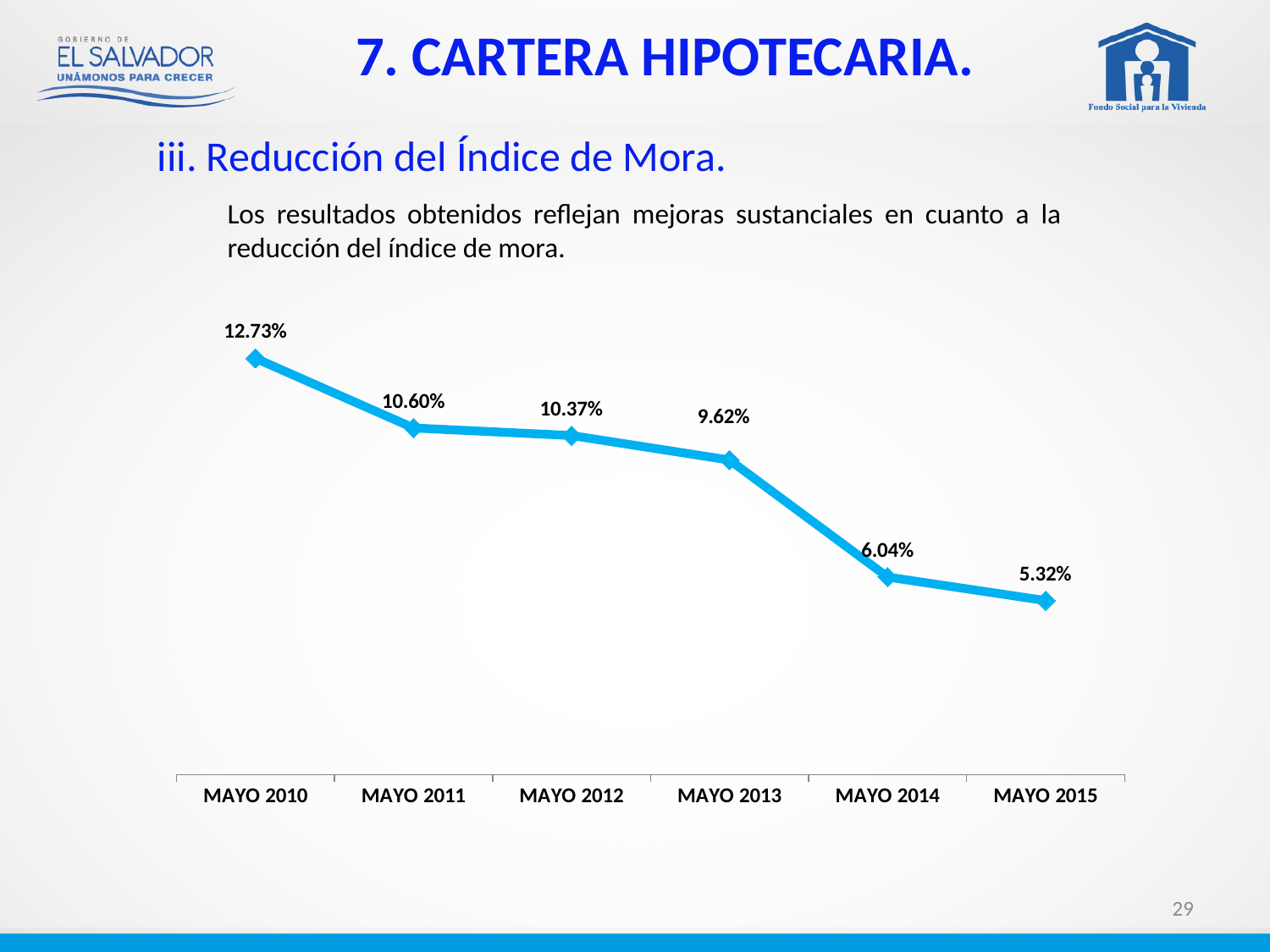
What is the value for MAYO 2015? 5.32% What is the difference between the values for MAYO 2013 and MAYO 2014? 3.58% Which category has the highest value? MAYO 2010 Which category has the lowest value? MAYO 2015 What is the value for MAYO 2010? 12.73% Do the values rise or fall from MAYO 2010 to MAYO 2015? Fall What kind of chart is shown on the slide? Line chart Which is larger, the value for MAYO 2011 or the value for MAYO 2014? MAYO 2011 What is the difference between the values for MAYO 2010 and MAYO 2015? 7.41% What is the value for MAYO 2012? 10.37% How many data points are plotted on the chart? 6 What is the value for MAYO 2013? 9.62%